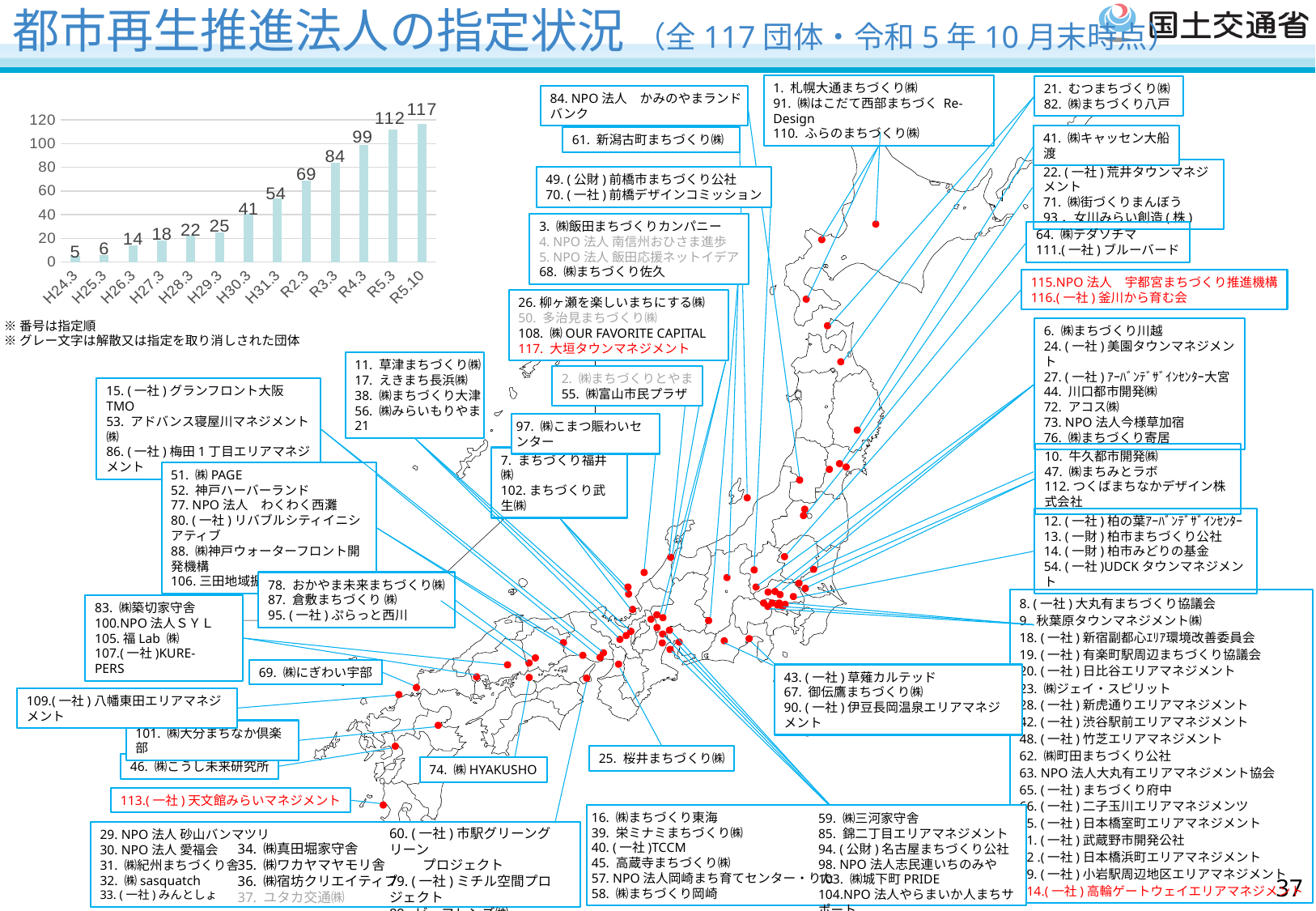
In the bar chart, what is the value for H24.3? 5 In the bar chart, which is larger, the value for H31.3 or the value for R3.3? R3.3 In the bar chart, what is the value for R2.3? 69 What type of chart is shown in the top-left of the slide? bar chart In the bar chart, what is the value for H30.3? 41 In the bar chart, what is the value for R5.10? 117 Which category in the bar chart has the highest value? R5.10 Do the values in the bar chart rise or fall from H24.3 to R5.10? rise In the bar chart, what is the difference between the values for H26.3 and H25.3? 8 How many categories are shown on the x axis of the bar chart? 13 Which category in the bar chart has the lowest value? H24.3 In the bar chart, what is the difference between the values for R5.3 and R4.3? 13